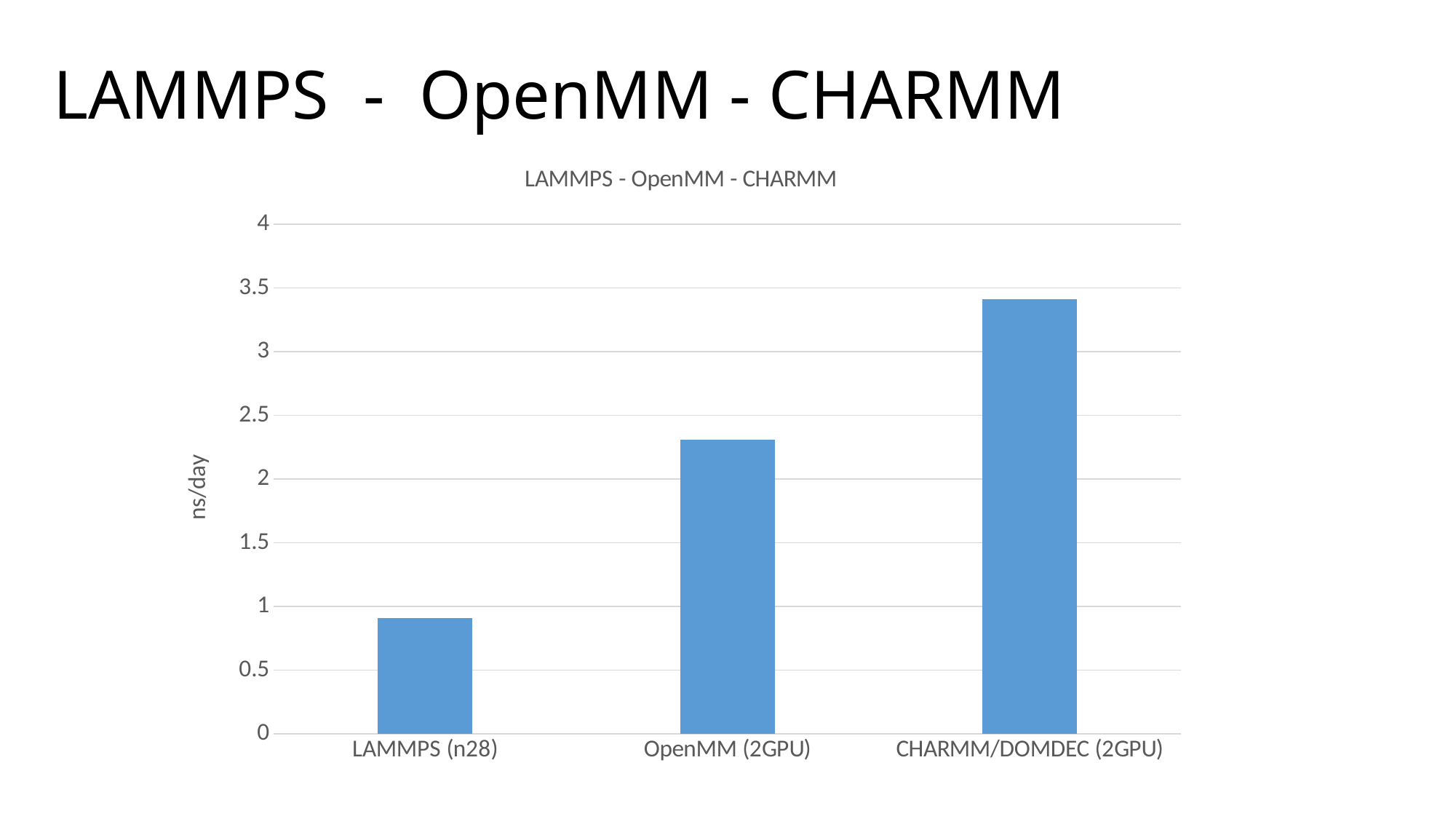
Is the value for CHARMM/DOMDEC (2GPU) greater or less than 3.5? less Which category has the highest value? CHARMM/DOMDEC (2GPU) How many categories are plotted in the chart? 3 Which is larger, the value for OpenMM (2GPU) or the value for LAMMPS (n28)? OpenMM (2GPU) What is the label of the vertical axis? ns/day Is the value for OpenMM (2GPU) greater or less than 2? greater Do the values rise or fall from left to right across the categories? rise Which category has the lowest value? LAMMPS (n28) Is the value for CHARMM/DOMDEC (2GPU) greater or less than 3? greater What is the title of the chart? LAMMPS - OpenMM - CHARMM What type of chart is shown on the slide? bar chart